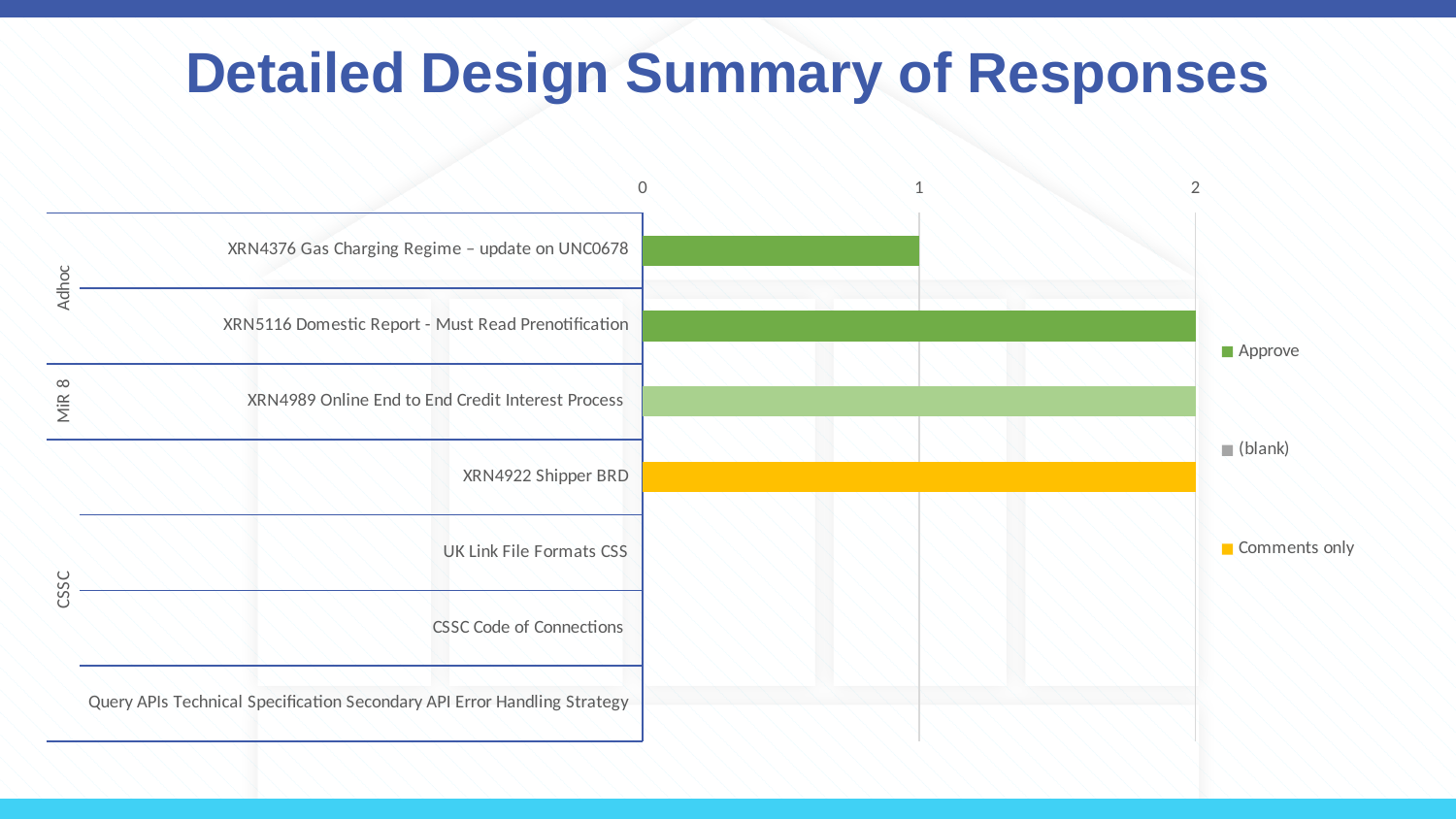
Which is larger, the value for XRN4376 Gas Charging Regime – update on UNC0678 or the value for XRN5116 Domestic Report - Must Read Prenotification? XRN5116 Domestic Report - Must Read Prenotification Is the value for XRN4376 Gas Charging Regime – update on UNC0678 greater or less than 2? less How many series does the legend list? 3 What is the value for XRN5116 Domestic Report - Must Read Prenotification? 2 How many categories are listed on the vertical axis of the chart? 7 What is the difference between the value for XRN5116 Domestic Report - Must Read Prenotification and the value for XRN4376 Gas Charging Regime – update on UNC0678? 1 What is the value for XRN4376 Gas Charging Regime – update on UNC0678? 1 What kind of chart is shown on the slide? bar chart Which series does the bar for XRN4922 Shipper BRD belong to, according to the legend? Comments only What is the value for XRN4922 Shipper BRD? 2 Which group on the vertical axis contains XRN4989 Online End to End Credit Interest Process? MiR 8